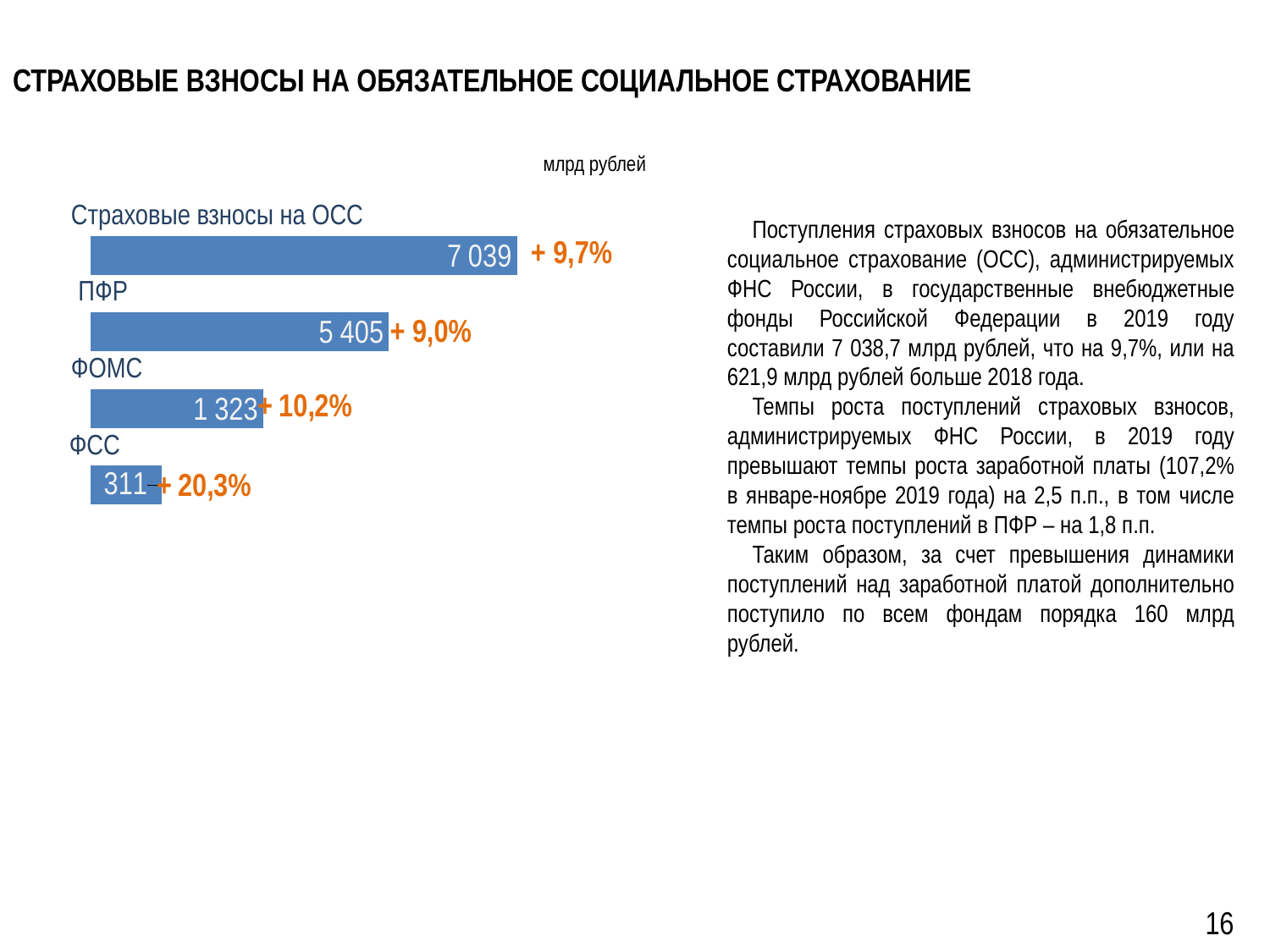
What growth percentage is shown next to the ФСС bar? + 20,3% What is the difference between the ПФР value and the ФОМС value? 4 082 What is the value of the bar for ФСС? 311 Which category has the highest bar value? Страховые взносы на ОСС How many bars are shown in the chart? 4 What type of chart is shown on the slide? Bar chart What is the value of the bar for ПФР? 5 405 Which is larger, the value for ФОМС or the value for ФСС? ФОМС What growth percentage is shown next to the ПФР bar? + 9,0% What is the value of the bar for ФОМС? 1 323 What is the value of the bar for Страховые взносы на ОСС? 7 039 Which category has the lowest bar value? ФСС